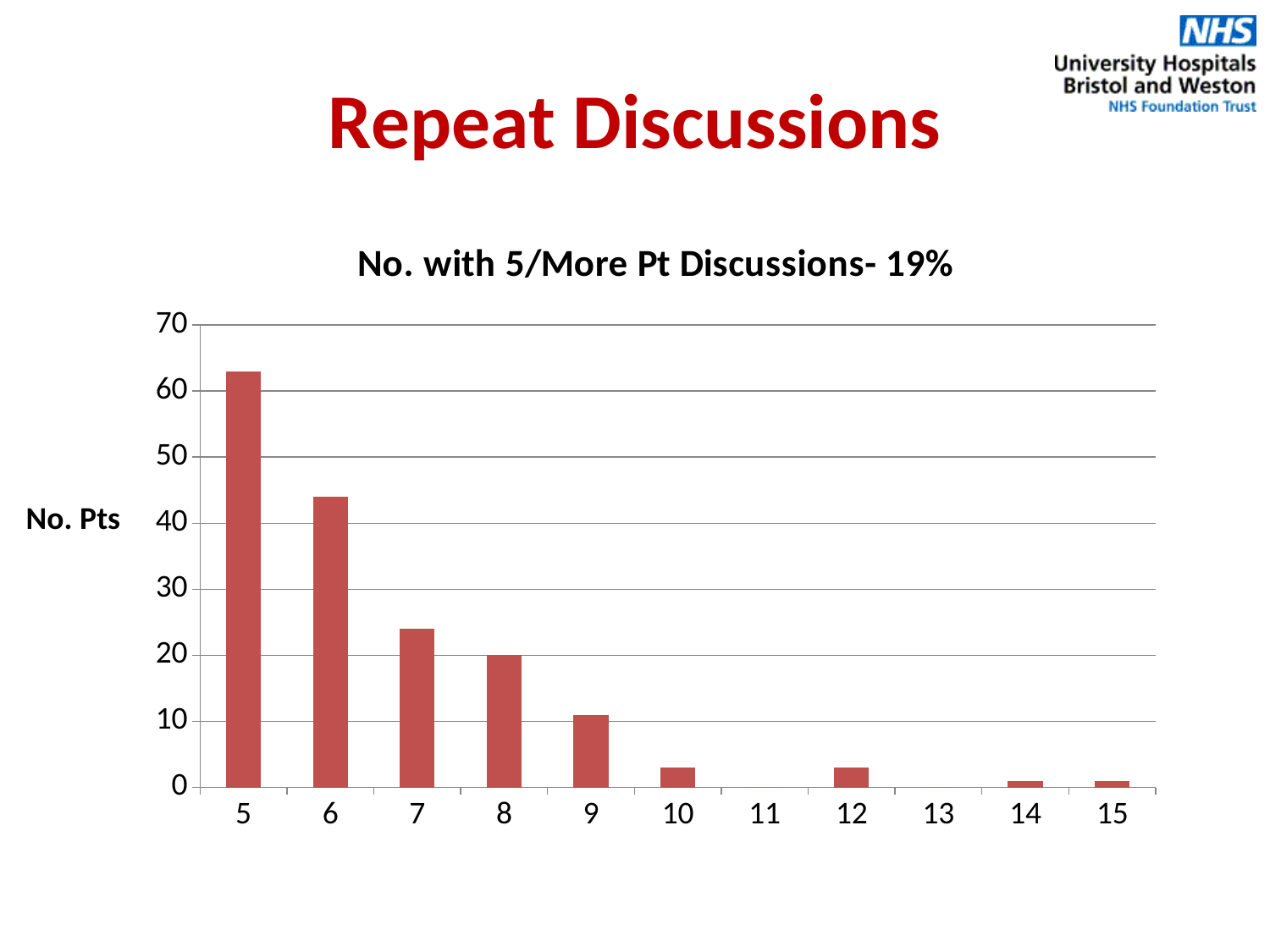
What is the title of the chart? No. with 5/More Pt Discussions- 19% Is the value for category 5 greater or less than 60? greater Is the value for category 7 greater or less than 20? greater What is the label on the vertical axis of the chart? No. Pts Do the values generally rise or fall as the x axis goes from 5 to 15? fall What type of chart is shown on the slide? bar chart Which category has the highest number of patients? 5 How many categories are shown on the x axis of the chart? 11 Is the value for category 6 greater or less than 50? less Which has the larger value, category 6 or category 7? 6